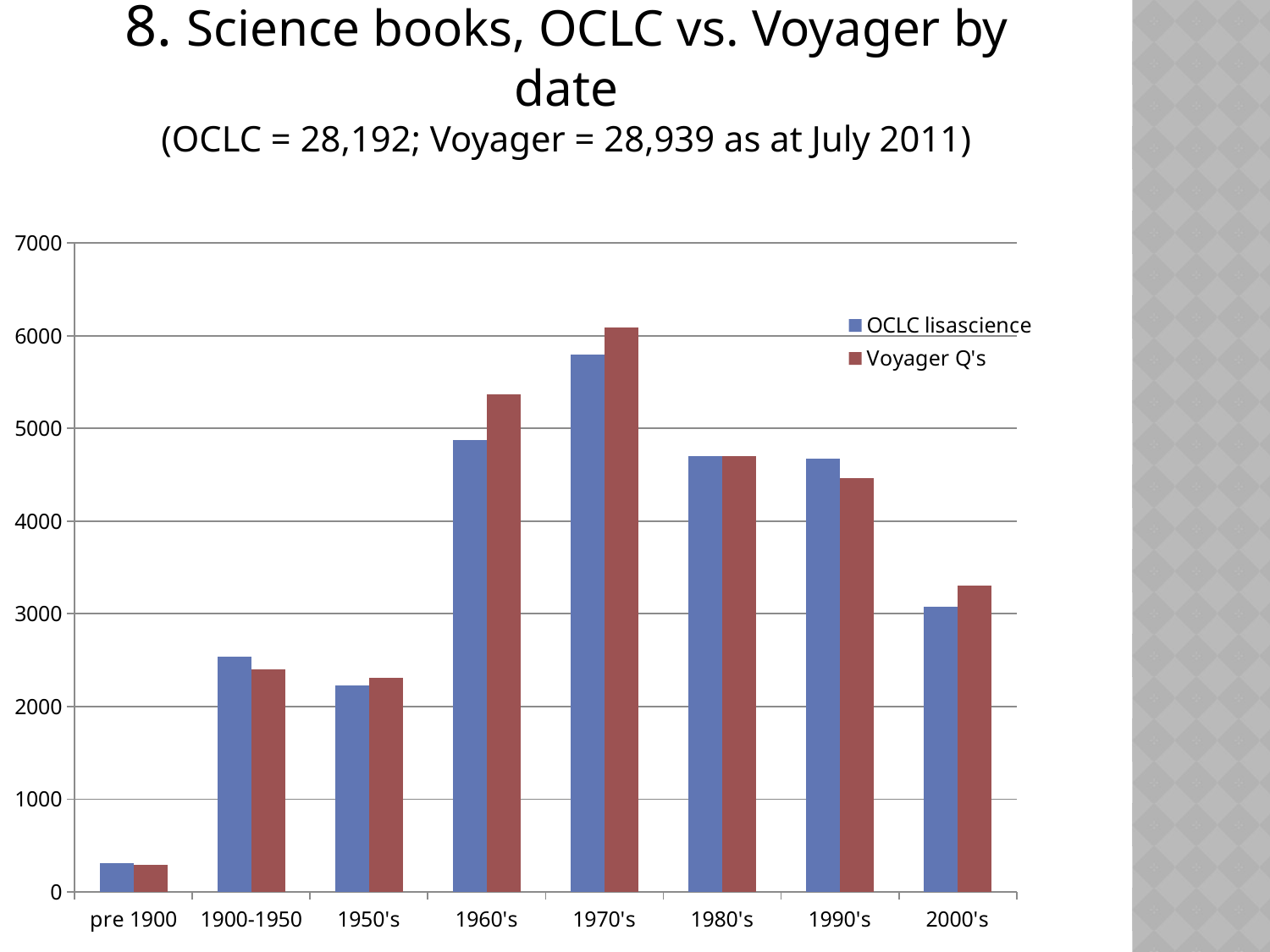
Which date category has the lowest value for Voyager Q's? pre 1900 Is the OCLC lisascience value for the 2000's greater or less than 3000? greater How many date categories are shown on the x axis? 8 Which date category has the highest value for OCLC lisascience? 1970's Is the OCLC lisascience value for the 1960's greater or less than 5000? less For the 1990's, which series has the larger value, OCLC lisascience or Voyager Q's? OCLC lisascience For the 1960's, which series has the larger value, OCLC lisascience or Voyager Q's? Voyager Q's How many series does the legend list? 2 What colour are the Voyager Q's bars? red Is the Voyager Q's value for the 1970's greater or less than 6000? greater What kind of chart is shown on the slide? bar chart